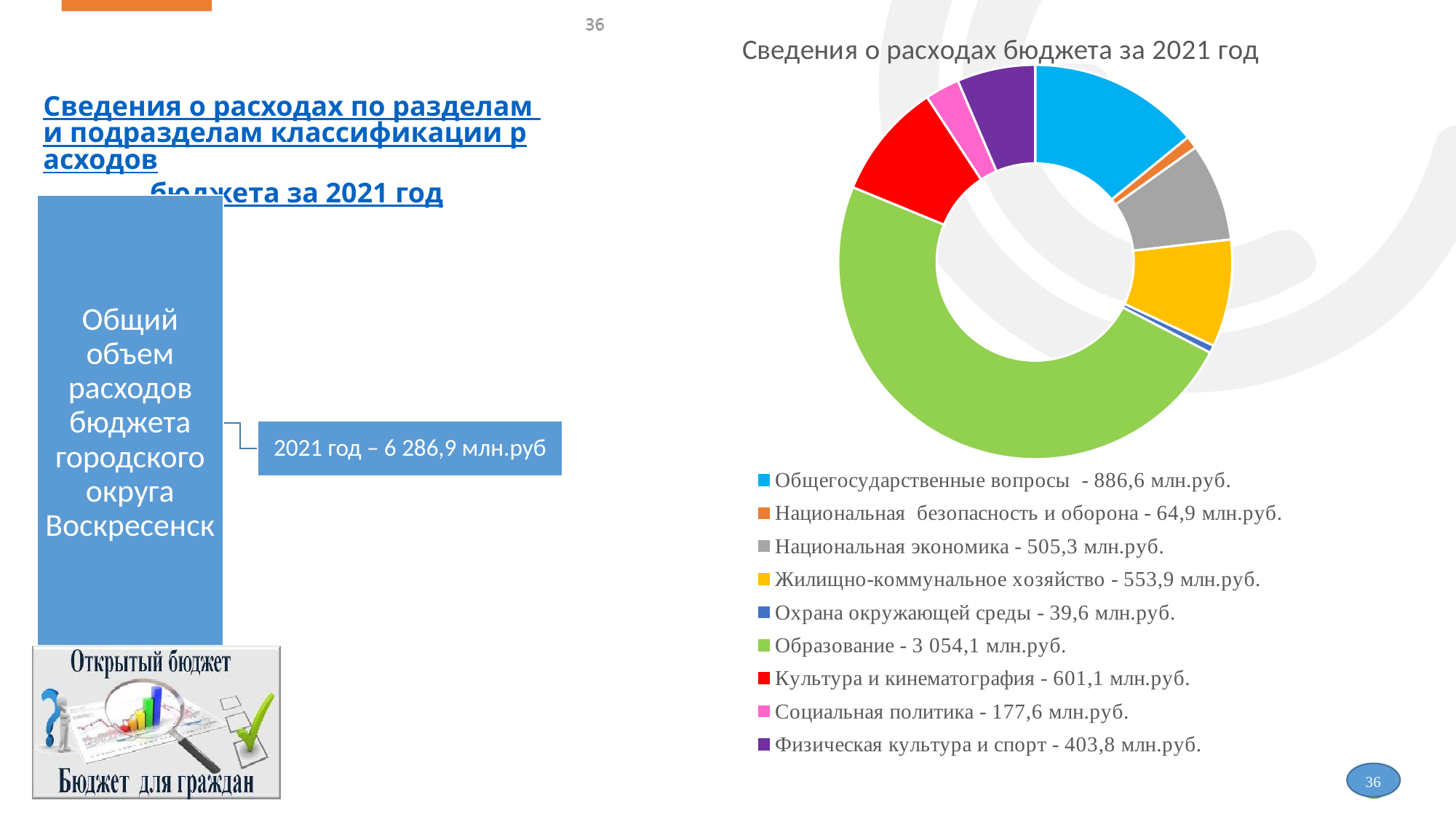
What is the value for Образование in the chart? 3 054,1 млн.руб. What kind of chart is shown on the slide? Doughnut (pie) chart Which category has the largest expenditure in the chart? Образование How many categories does the chart show? 9 What is the difference between Культура и кинематография and Жилищно-коммунальное хозяйство? 47,2 млн.руб. What is the value for Физическая культура и спорт? 403,8 млн.руб. Which is larger: Национальная экономика or Социальная политика? Национальная экономика What is the title of the chart? Сведения о расходах бюджета за 2021 год What is the difference between Образование and Общегосударственные вопросы? 2 167,5 млн.руб. What is the value for Охрана окружающей среды? 39,6 млн.руб. Which category has the smallest expenditure in the chart? Охрана окружающей среды What is the value for Жилищно-коммунальное хозяйство? 553,9 млн.руб.